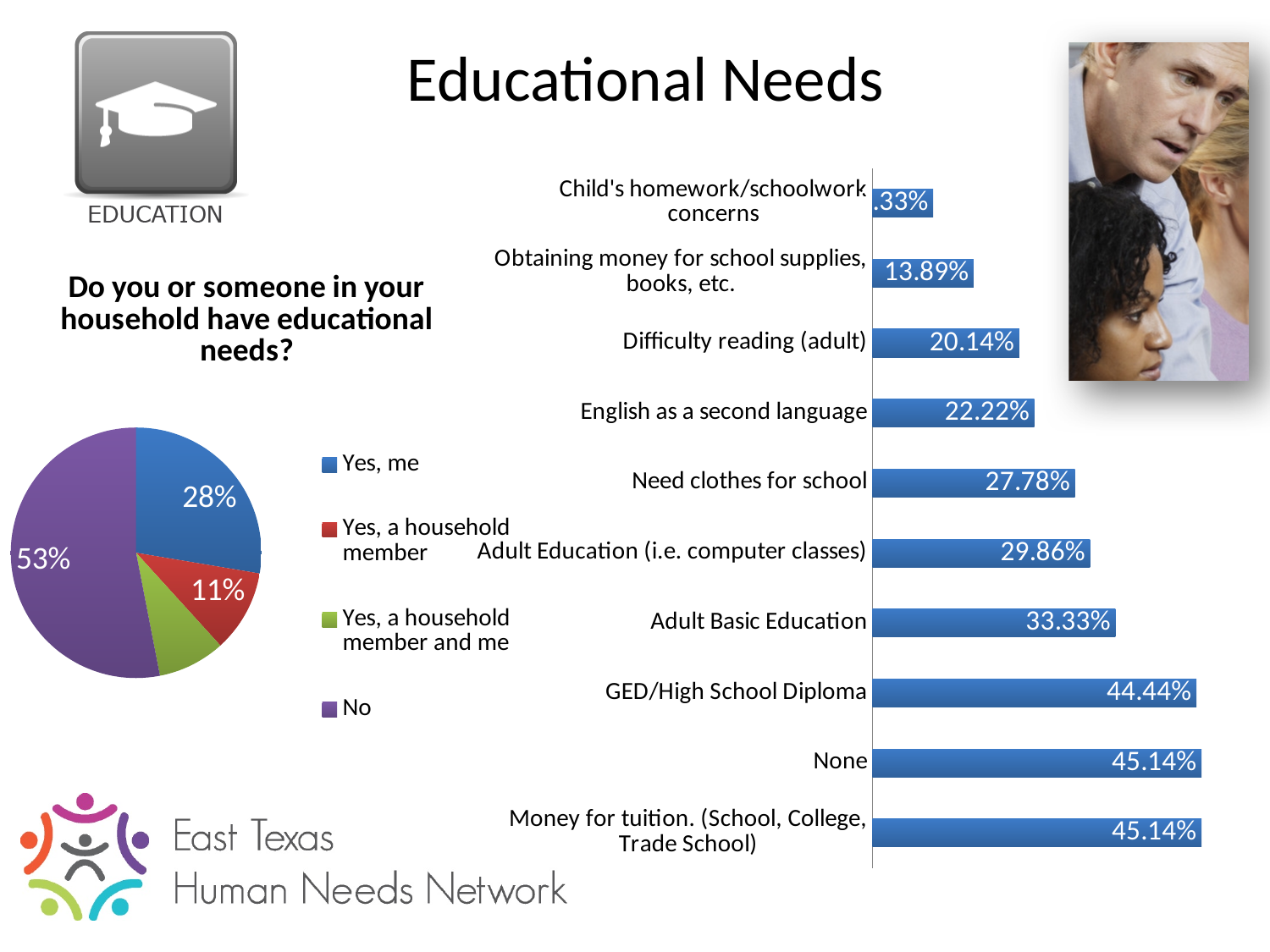
In the pie chart, what share is labelled for the No slice? 53% What kind of chart is the chart on the right side of the slide? Bar chart In the bar chart, what is the value for Obtaining money for school supplies, books, etc.? 13.89% In the bar chart, what is the difference between Adult Basic Education and Need clothes for school? 5.55% In the bar chart, what is the value for Difficulty reading (adult)? 20.14% How many entries does the pie chart's legend list? 4 In the pie chart, which is larger: Yes, me or Yes, a household member? Yes, me In the bar chart, which category has the lowest value? Child's homework/schoolwork concerns In the bar chart, what is the value for GED/High School Diploma? 44.44% In the pie chart, what is the value for Yes, me? 28% How many categories does the bar chart show? 10 In the bar chart, which is larger: English as a second language or Adult Education (i.e. computer classes)? Adult Education (i.e. computer classes)